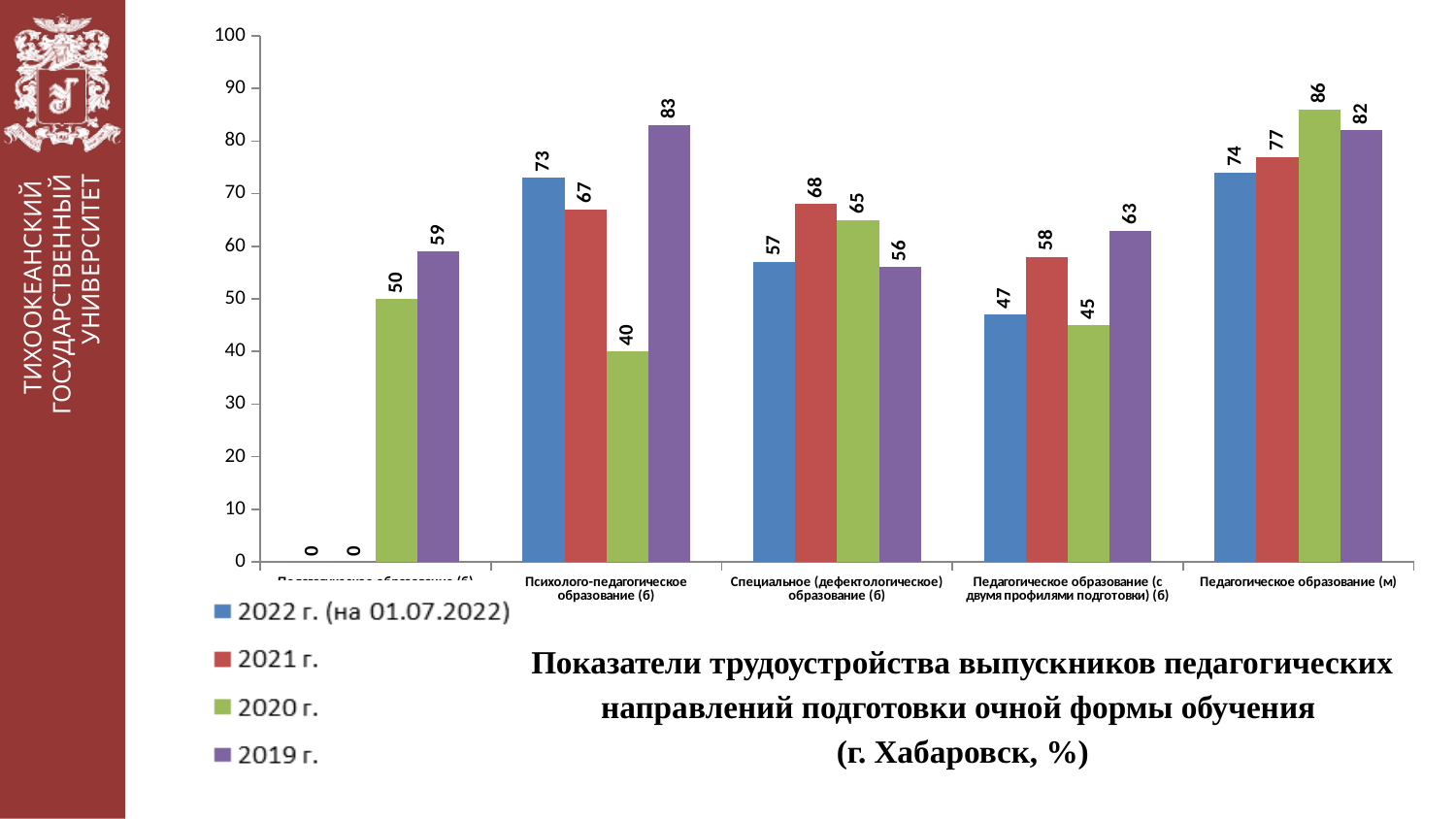
What type of chart is shown on the slide? bar chart What is the value for 2022 г. (на 01.07.2022) in the category Педагогическое образование (с двумя профилями подготовки) (б)? 47 What is the difference between the 2019 г. and 2020 г. values in the category Психолого-педагогическое образование (б)? 43 What is the value for 2019 г. in the category Психолого-педагогическое образование (б)? 83 How many series does the legend list? 4 Which series has the highest value in the category Педагогическое образование (м)? 2020 г. What is the title of the chart? Показатели трудоустройства выпускников педагогических направлений подготовки очной формы обучения (г. Хабаровск, %) How many categories are shown on the x axis? 5 In the category Специальное (дефектологическое) образование (б), which is larger: the value for 2022 г. (на 01.07.2022) or the value for 2021 г.? 2021 г. Which series has the lowest value in the category Психолого-педагогическое образование (б)? 2020 г. What is the value for 2021 г. in the category Специальное (дефектологическое) образование (б)? 68 What is the value for 2020 г. in the category Педагогическое образование (м)? 86